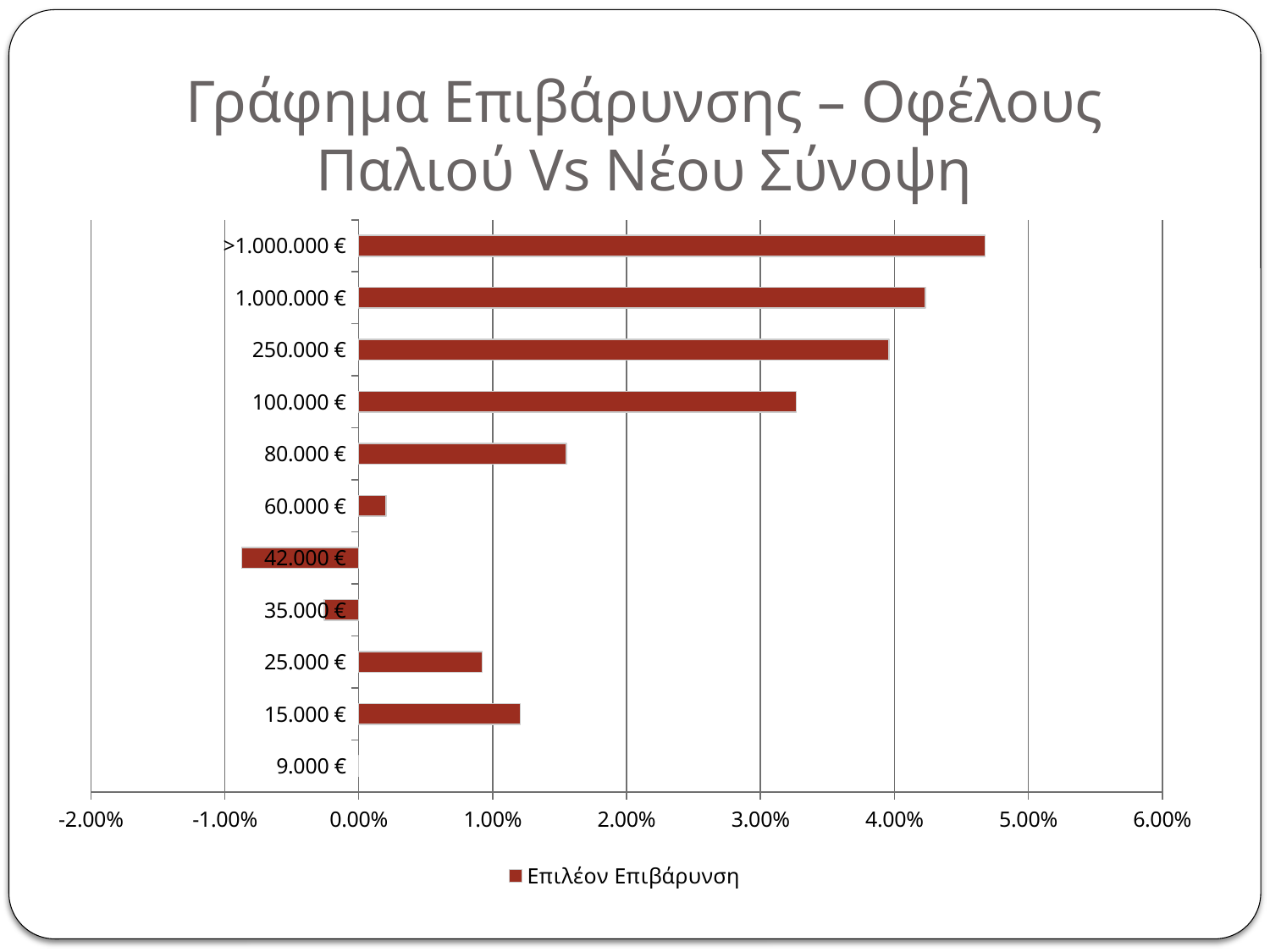
Which is larger, the value for 15.000 € or the value for 25.000 €? 15.000 € Is the value for >1.000.000 € greater or less than 4.00%? greater Is the value for 42.000 € greater or less than 0.00%? less Is the value for 100.000 € greater or less than 3.00%? greater Which category has the highest value? >1.000.000 € Which category has the lowest value? 42.000 € Which is larger, the value for 250.000 € or the value for 100.000 €? 250.000 € How many categories are shown on the vertical axis of the chart? 11 What is the name of the series shown in the legend? Επιλέον Επιβάρυνση How many series does the legend list? 1 What kind of chart is shown on the slide? bar chart